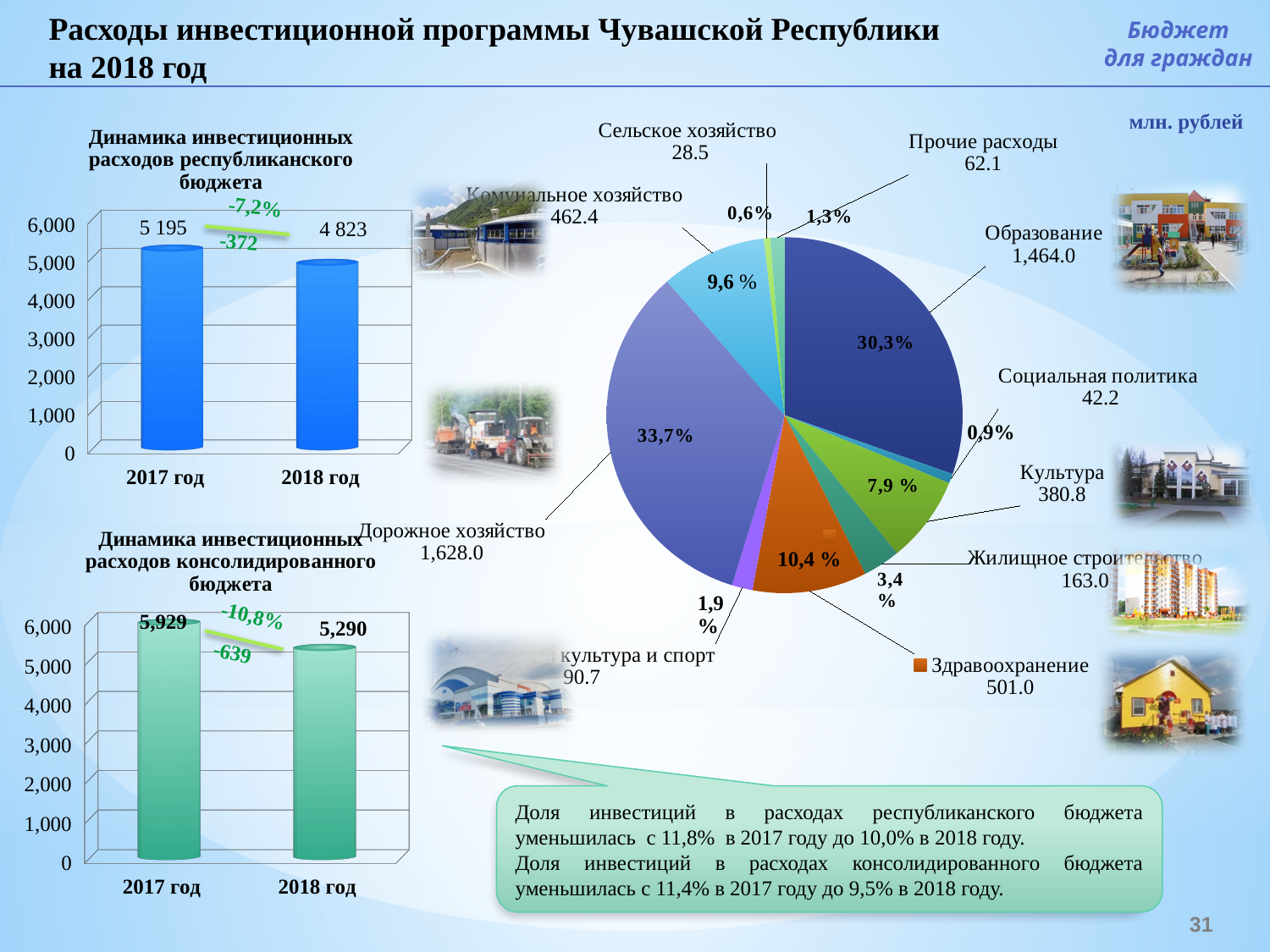
In the pie chart, which category has the smallest slice? Сельское хозяйство In the chart 'Динамика инвестиционных расходов консолидированного бюджета', what is the difference between the 2017 год and 2018 год values? 639 What kind of chart is 'Динамика инвестиционных расходов республиканского бюджета'? bar chart How many categories does the pie chart show? 10 In the chart 'Динамика инвестиционных расходов консолидированного бюджета', what is the value for 2018 год? 5,290 In the chart 'Динамика инвестиционных расходов консолидированного бюджета', do the values rise or fall from 2017 год to 2018 год? fall In the chart 'Динамика инвестиционных расходов республиканского бюджета', what is the value for 2017 год? 5 195 In the pie chart, what is the value for Дорожное хозяйство? 1,628.0 In the pie chart, which category has the largest slice? Дорожное хозяйство In the pie chart, what share does Образование have? 30,3% In the pie chart, which is larger: Здравоохранение or Культура? Здравоохранение In the chart 'Динамика инвестиционных расходов республиканского бюджета', what is the value for 2018 год? 4 823